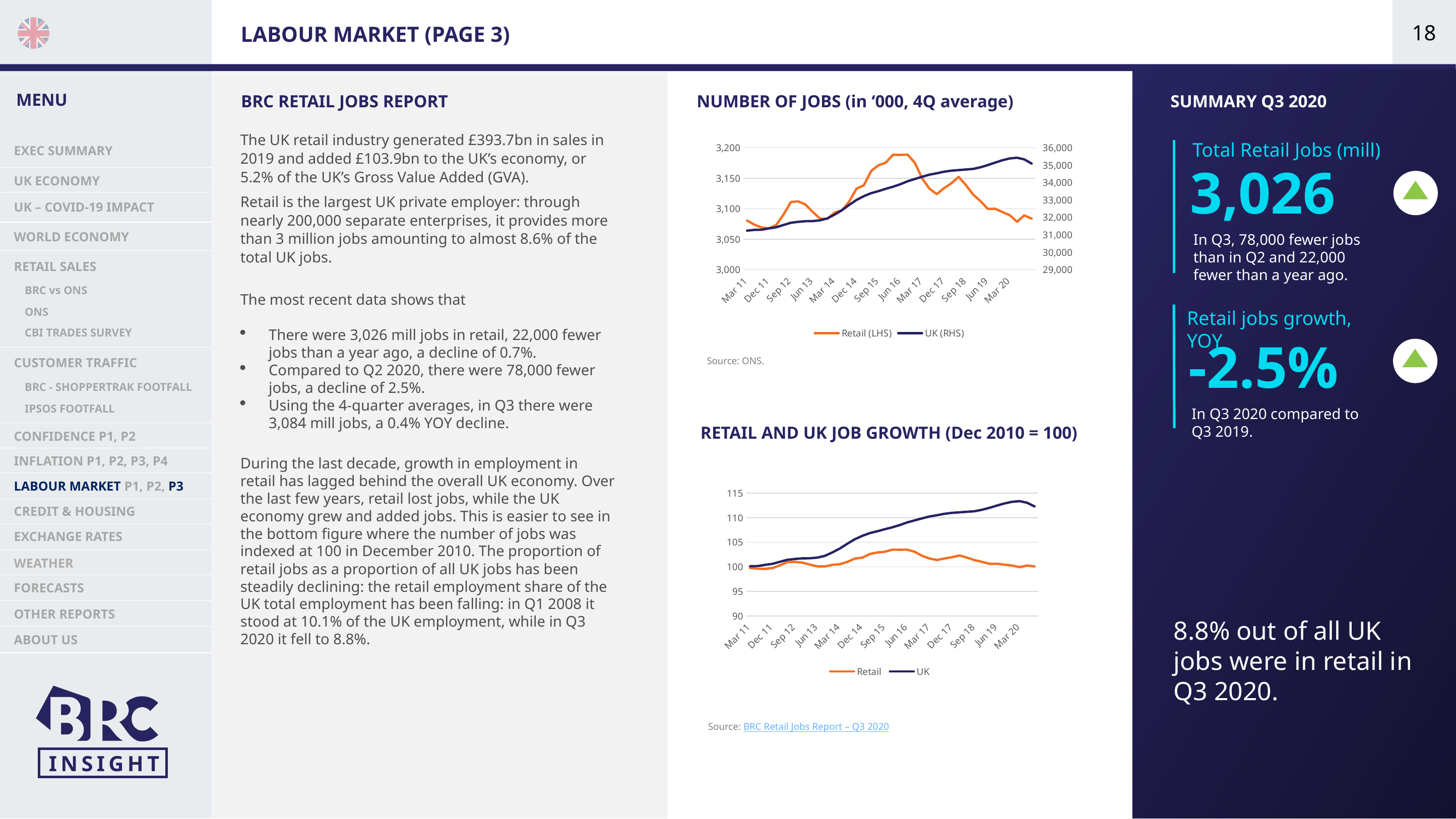
How many series does the legend of the 'NUMBER OF JOBS (in '000, 4Q average)' chart list? 2 How many series does the legend of the 'RETAIL AND UK JOB GROWTH (Dec 2010 = 100)' chart list? 2 In the 'NUMBER OF JOBS (in '000, 4Q average)' chart, which series is plotted on the right-hand axis? UK (RHS) In the 'NUMBER OF JOBS (in '000, 4Q average)' chart, is the Retail (LHS) value at Jun 16 greater or less than 3,150? greater In the 'NUMBER OF JOBS (in '000, 4Q average)' chart, does the UK (RHS) line generally rise or fall from Mar 11 to Jun 19? rise In the 'RETAIL AND UK JOB GROWTH (Dec 2010 = 100)' chart, is the Retail value at Mar 20 greater or less than 105? less What kind of chart is the 'RETAIL AND UK JOB GROWTH (Dec 2010 = 100)' chart? line chart In the 'NUMBER OF JOBS (in '000, 4Q average)' chart, is the UK (RHS) value at Mar 20 greater or less than 34,000? greater What kind of chart is the 'NUMBER OF JOBS (in '000, 4Q average)' chart? line chart In the 'RETAIL AND UK JOB GROWTH (Dec 2010 = 100)' chart, which series is higher at Mar 20, Retail or UK? UK